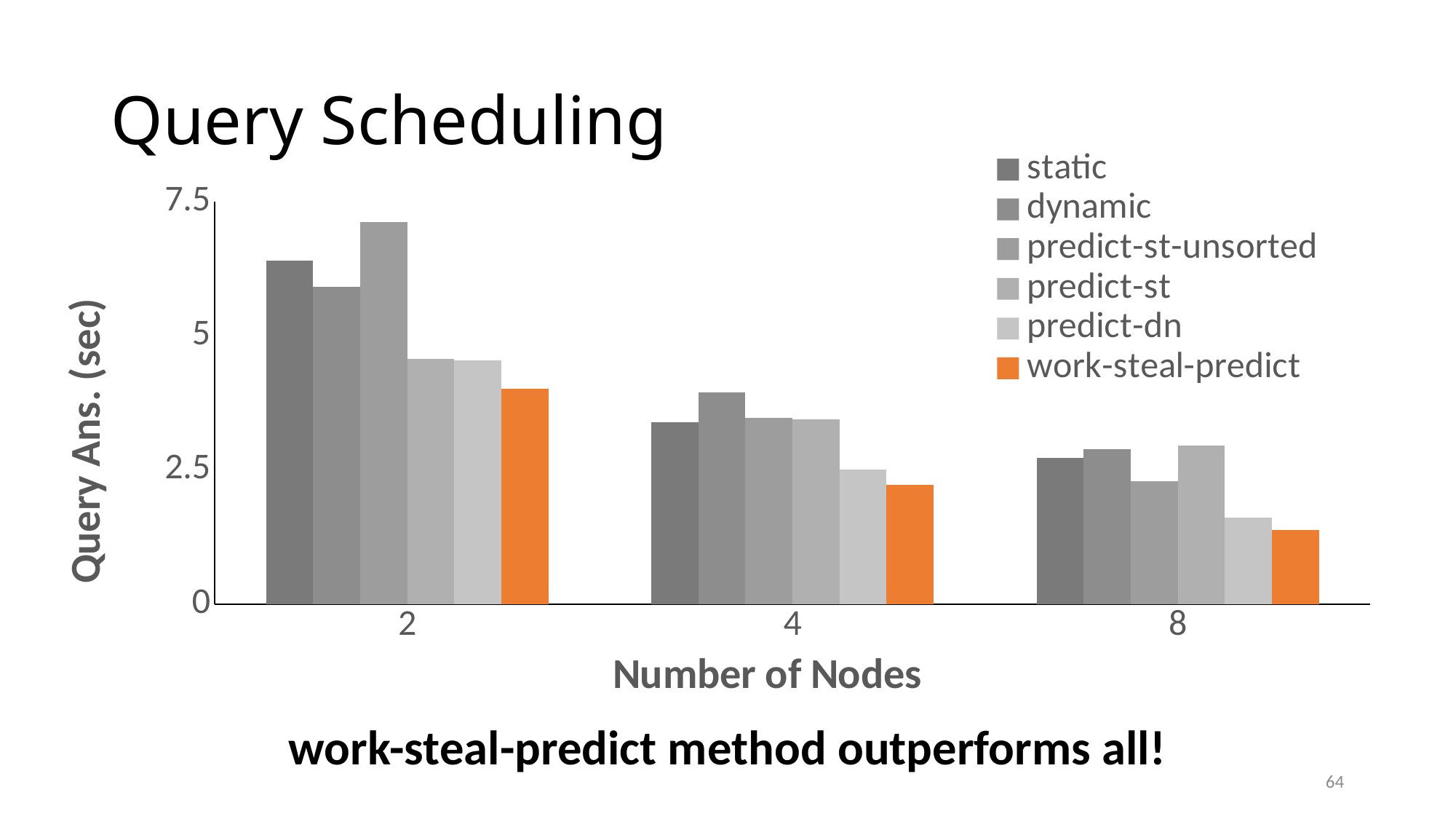
How many node-count categories are shown on the x axis? 3 Which series has the highest value at 2 nodes? predict-st-unsorted Is the value for predict-st-unsorted at 2 nodes greater or less than 5? greater Is the value for work-steal-predict at 2 nodes greater or less than 5? less How many series does the legend list? 6 What kind of chart is shown on the slide? bar chart Does the value for work-steal-predict rise or fall as the number of nodes increases from 2 to 8? fall Is the value for dynamic at 4 nodes greater or less than 2.5? greater At 4 nodes, which is larger: the value for dynamic or the value for work-steal-predict? dynamic Which series has the lowest value at 8 nodes? work-steal-predict What is the label of the y axis? Query Ans. (sec)